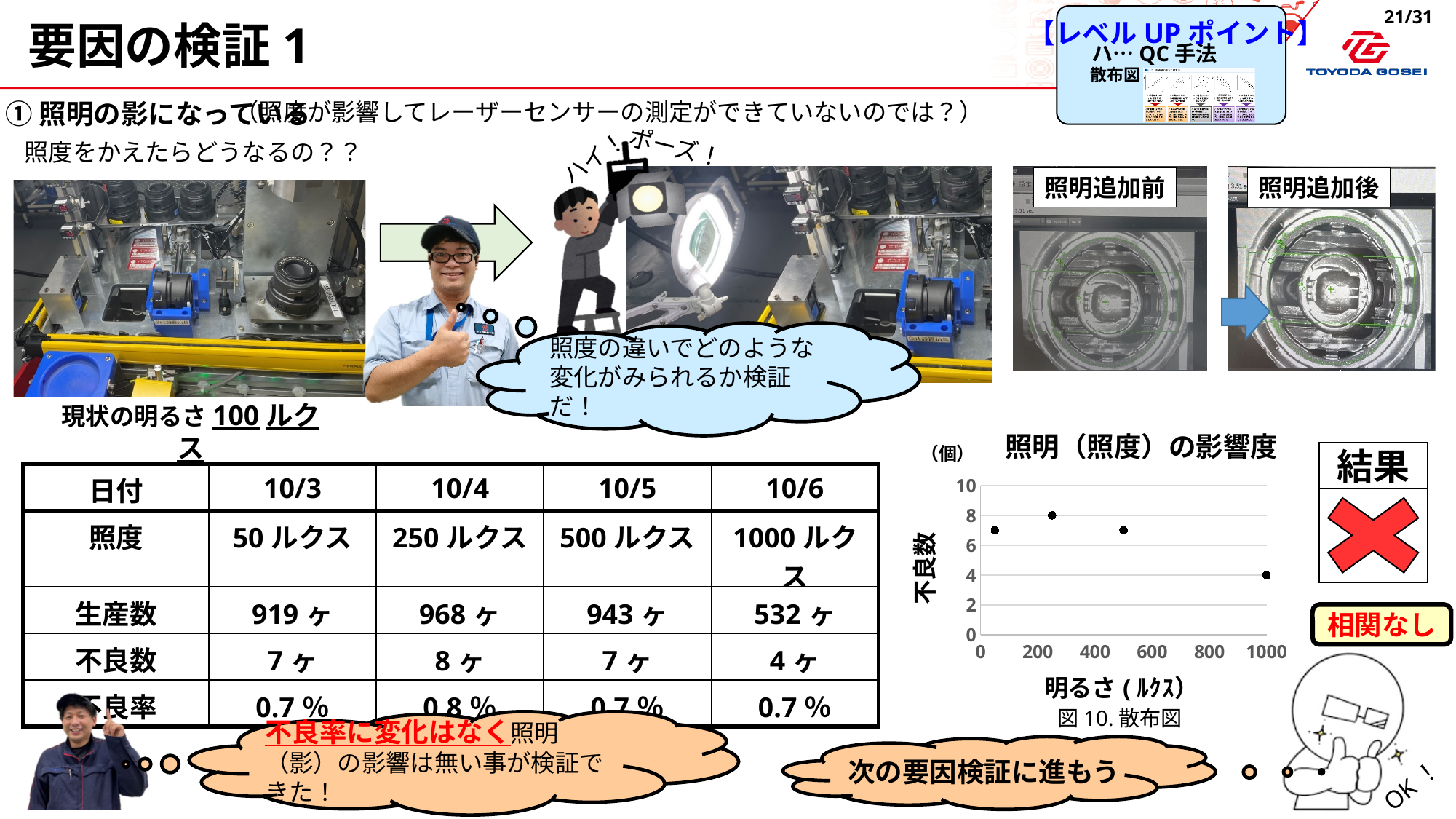
What is the label of the x axis of the 照明（照度）の影響度 chart? 明るさ (ルクス) In the 照明（照度）の影響度 chart, which has the larger 不良数: 250 ルクス or 1000 ルクス? 250 ルクス In the 照明（照度）の影響度 chart, is the 不良数 at 1000 ルクス greater or less than 6? less In the 照明（照度）の影響度 chart, at which brightness (ルクス) is the 不良数 lowest? 1000 What is the figure caption written below the 照明（照度）の影響度 chart? 図 10. 散布図 In the 照明（照度）の影響度 chart, at which brightness (ルクス) is the 不良数 highest? 250 In the 照明（照度）の影響度 chart, what is the 不良数 at 1000 ルクス? 4 In the 照明（照度）の影響度 chart, what is the difference in 不良数 between 250 ルクス and 1000 ルクス? 4 In the 照明（照度）の影響度 chart, is the 不良数 at 500 ルクス greater or less than 6? greater In the 照明（照度）の影響度 chart, what is the 不良数 at 250 ルクス? 8 What kind of chart is shown under the title 照明（照度）の影響度? Scatter chart How many data points are plotted in the 照明（照度）の影響度 chart? 4